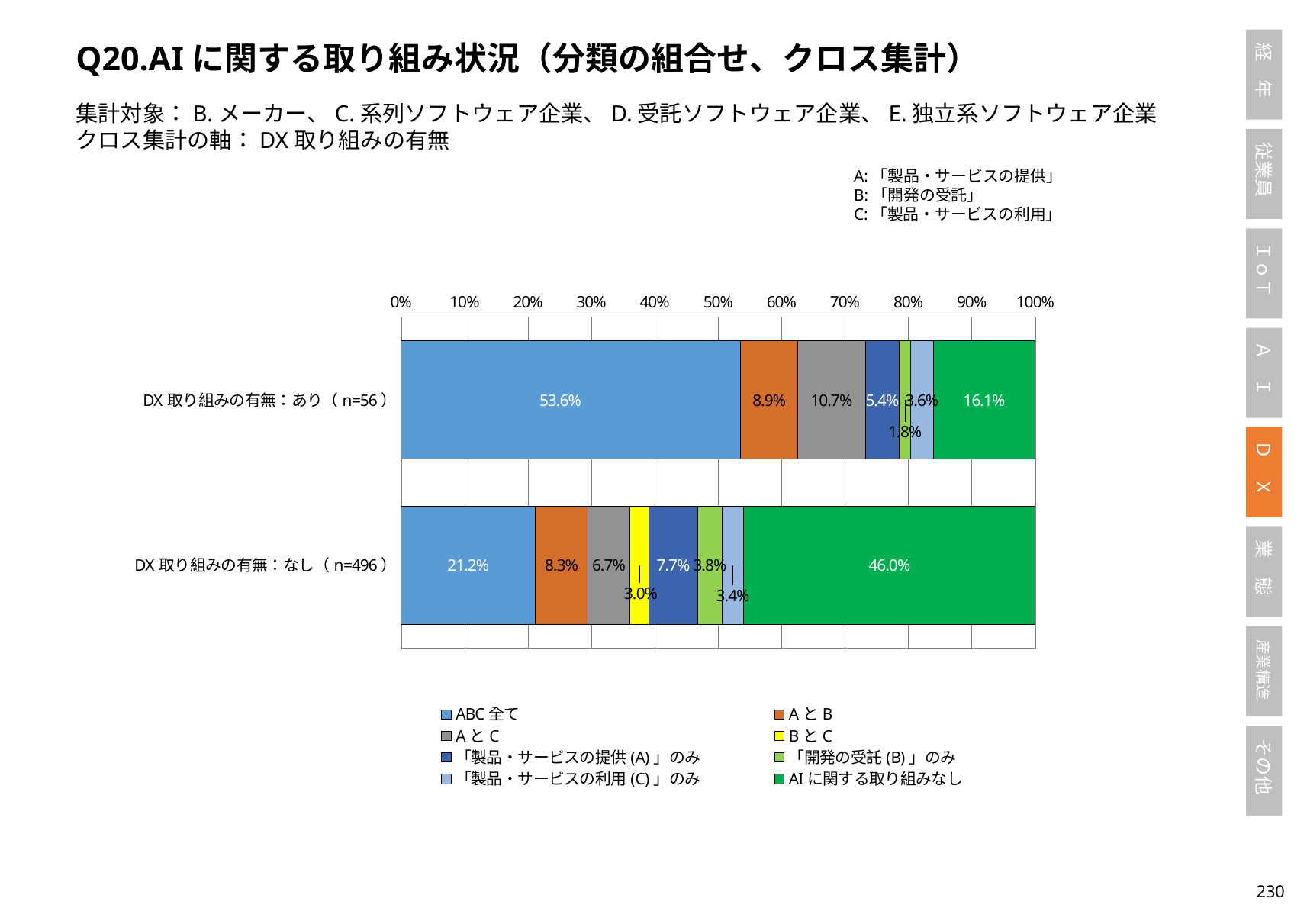
How many categories (bars) are plotted in the chart? 2 What is the value of 「B と C」 for DX 取り組みの有無：なし (n=496)? 3.0% Which segment is the largest in the DX 取り組みの有無：なし (n=496) bar? AI に関する取り組みなし What is the difference between the 「ABC 全て」 values for DX 取り組みの有無：あり and DX 取り組みの有無：なし? 32.4% What type of chart is shown on the slide? Stacked bar chart What is the value of 「AI に関する取り組みなし」 for DX 取り組みの有無：なし (n=496)? 46.0% What is the value of 「製品・サービスの提供 (A)」のみ for DX 取り組みの有無：なし (n=496)? 7.7% Which is larger: 「A と B」 for DX 取り組みの有無：あり or 「A と B」 for DX 取り組みの有無：なし? DX 取り組みの有無：あり How many series does the legend list? 8 Which segment is the smallest in the DX 取り組みの有無：あり (n=56) bar? 「開発の受託 (B)」のみ What is the value of 「ABC 全て」 for DX 取り組みの有無：あり (n=56)? 53.6% What is the value of 「A と C」 for DX 取り組みの有無：あり (n=56)? 10.7%